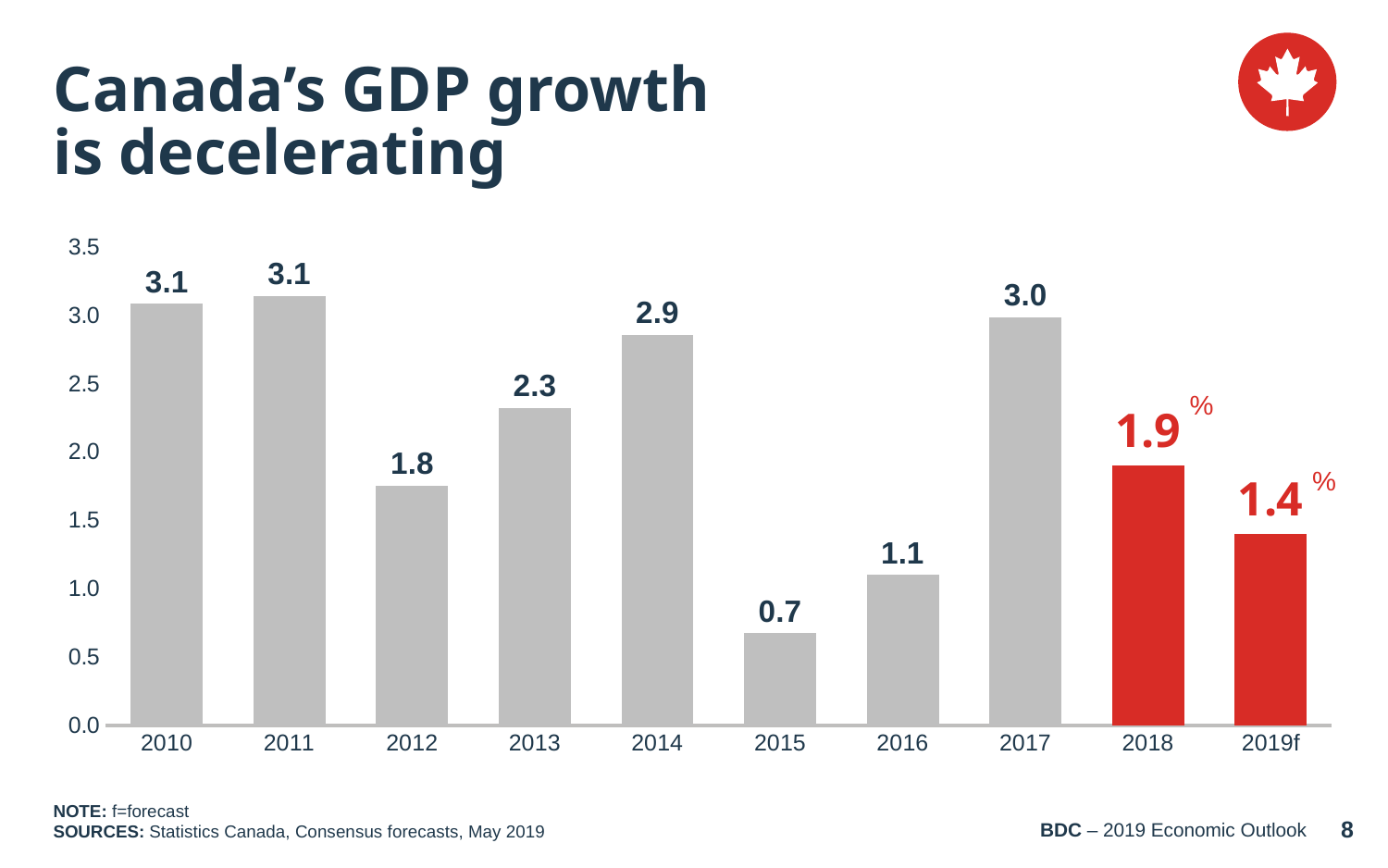
Which year has the lowest GDP growth value on the chart? 2015 Which bars on the chart are coloured red rather than grey? 2018 and 2019f What is the GDP growth value shown for 2015? 0.7 Is the GDP growth value for 2014 greater or less than 2.5? greater What kind of chart is shown on the slide? Bar chart What is the GDP growth value shown for 2018? 1.9% How many years are shown on the x axis of the chart? 10 What is the difference between the GDP growth values for 2018 and 2019f? 0.5 What is the difference between the GDP growth values for 2017 and 2016? 1.9 What is the GDP growth value shown for 2017? 3.0 What is the forecast GDP growth value shown for 2019f? 1.4% Which year has the larger GDP growth value, 2013 or 2012? 2013